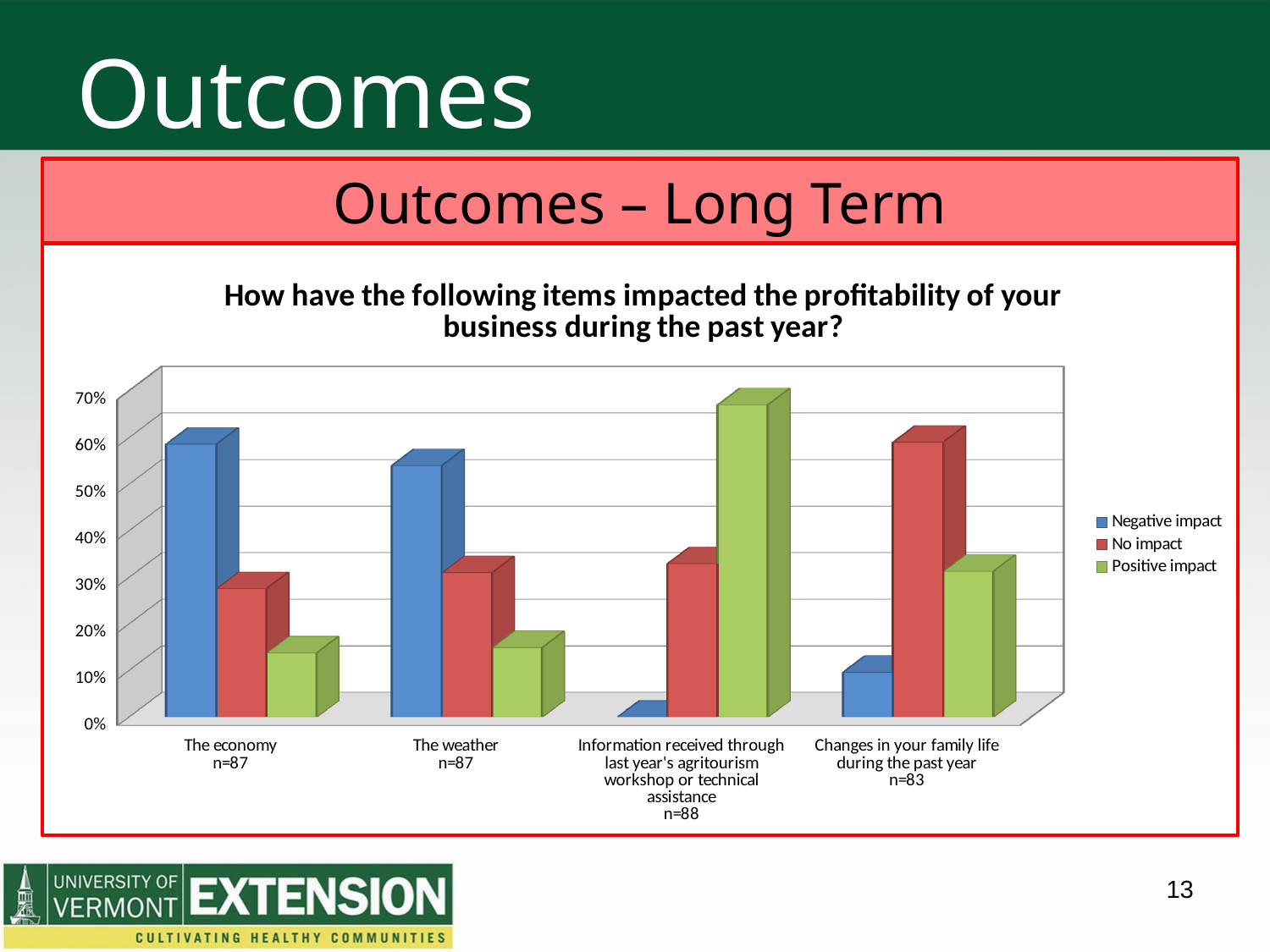
Which category has the lowest Negative impact value? Information received through last year's agritourism workshop or technical assistance Which category has the highest Positive impact value? Information received through last year's agritourism workshop or technical assistance For Changes in your family life during the past year, which is larger: No impact or Positive impact? No impact What colour represents Positive impact in the legend? Green What kind of chart is shown on the slide? Bar chart For The weather, which is larger: Negative impact or No impact? Negative impact How many series does the legend list? 3 How many categories are shown along the x axis? 4 Which category has the highest Negative impact value? The economy Is the Positive impact value for The economy greater or less than 20%? less Is the Negative impact value for The economy greater or less than 50%? greater Is the No impact value for Changes in your family life during the past year greater or less than 50%? greater